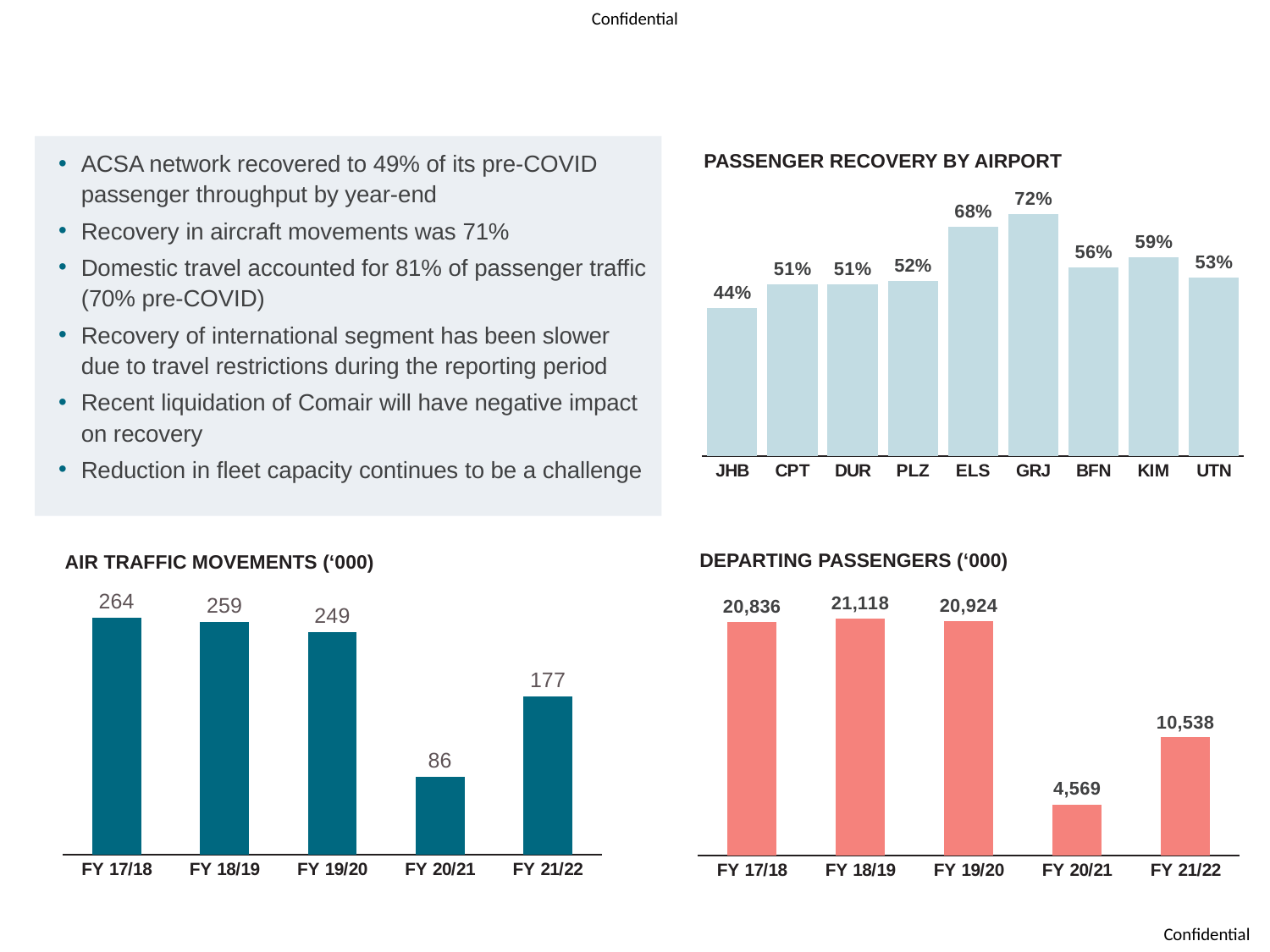
In the PASSENGER RECOVERY BY AIRPORT chart, how many airports are shown? 9 In the AIR TRAFFIC MOVEMENTS ('000) chart, what is the value for FY 20/21? 86 In the AIR TRAFFIC MOVEMENTS ('000) chart, what is the difference between FY 21/22 and FY 20/21? 91 In the PASSENGER RECOVERY BY AIRPORT chart, which airport has the highest recovery? GRJ In the PASSENGER RECOVERY BY AIRPORT chart, what is the difference between ELS and JHB? 24% What kind of chart is the DEPARTING PASSENGERS ('000) chart? Bar chart In the PASSENGER RECOVERY BY AIRPORT chart, what is the value for GRJ? 72% In the DEPARTING PASSENGERS ('000) chart, what is the value for FY 18/19? 21,118 In the AIR TRAFFIC MOVEMENTS ('000) chart, which year has the highest value? FY 17/18 In the DEPARTING PASSENGERS ('000) chart, which year has the lowest value? FY 20/21 In the PASSENGER RECOVERY BY AIRPORT chart, which airport has the lowest recovery? JHB In the DEPARTING PASSENGERS ('000) chart, which is larger, FY 17/18 or FY 19/20? FY 19/20